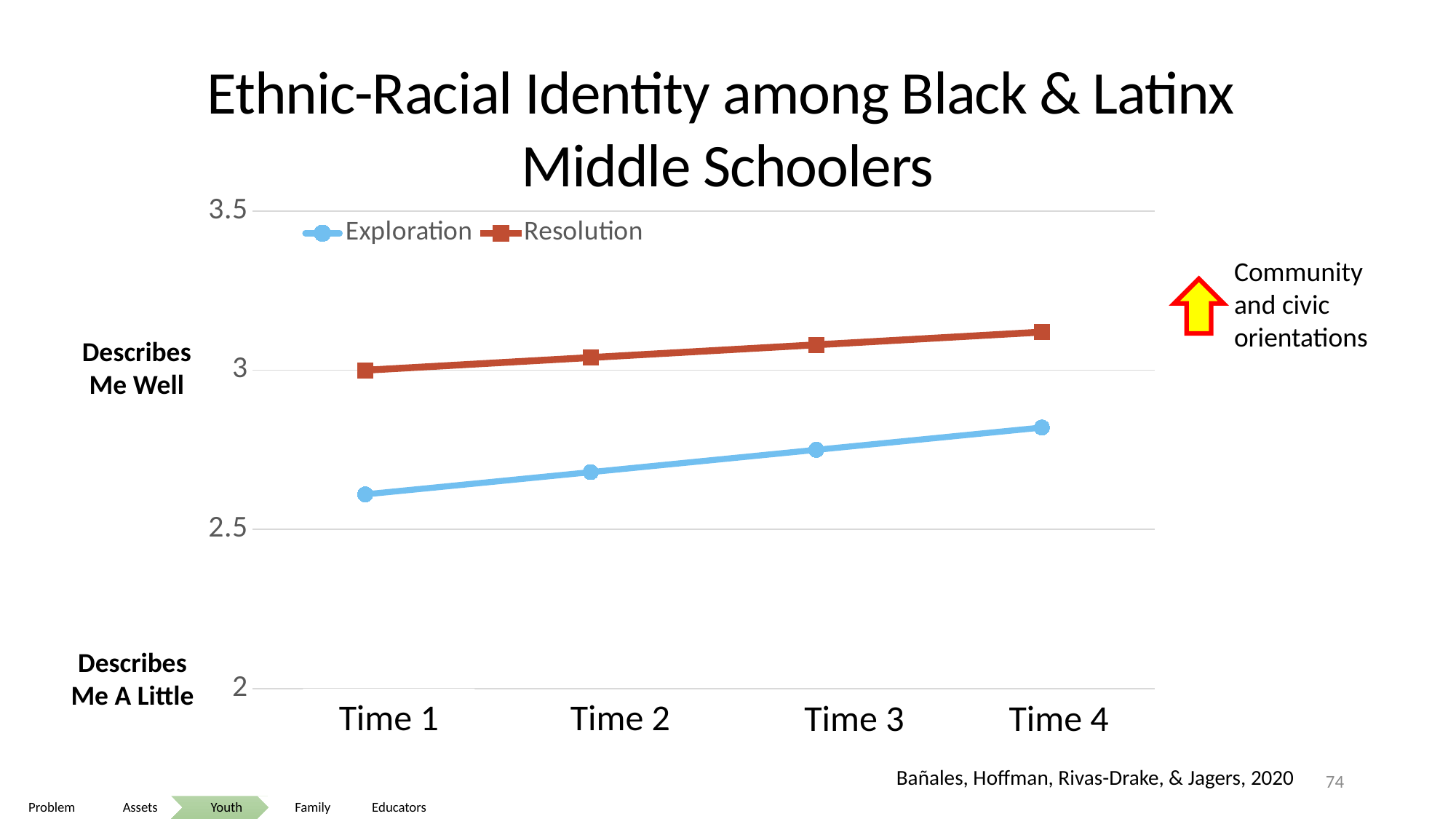
Is the Exploration value at Time 1 greater or less than 2.5? greater At Time 4, which series has the larger value, Exploration or Resolution? Resolution Is the Exploration value at Time 4 greater or less than 3? less How many series does the legend list? 2 Do the Resolution values rise or fall from Time 1 to Time 4? rise Do the Exploration values rise or fall from Time 1 to Time 4? rise How many time points are plotted along the x axis? 4 What kind of chart is shown on the slide? line chart At which time point is the Exploration value lowest? Time 1 At which time point is the Exploration value highest? Time 4 Is the Resolution value at Time 4 greater or less than 3? greater Which series is drawn with the blue line? Exploration